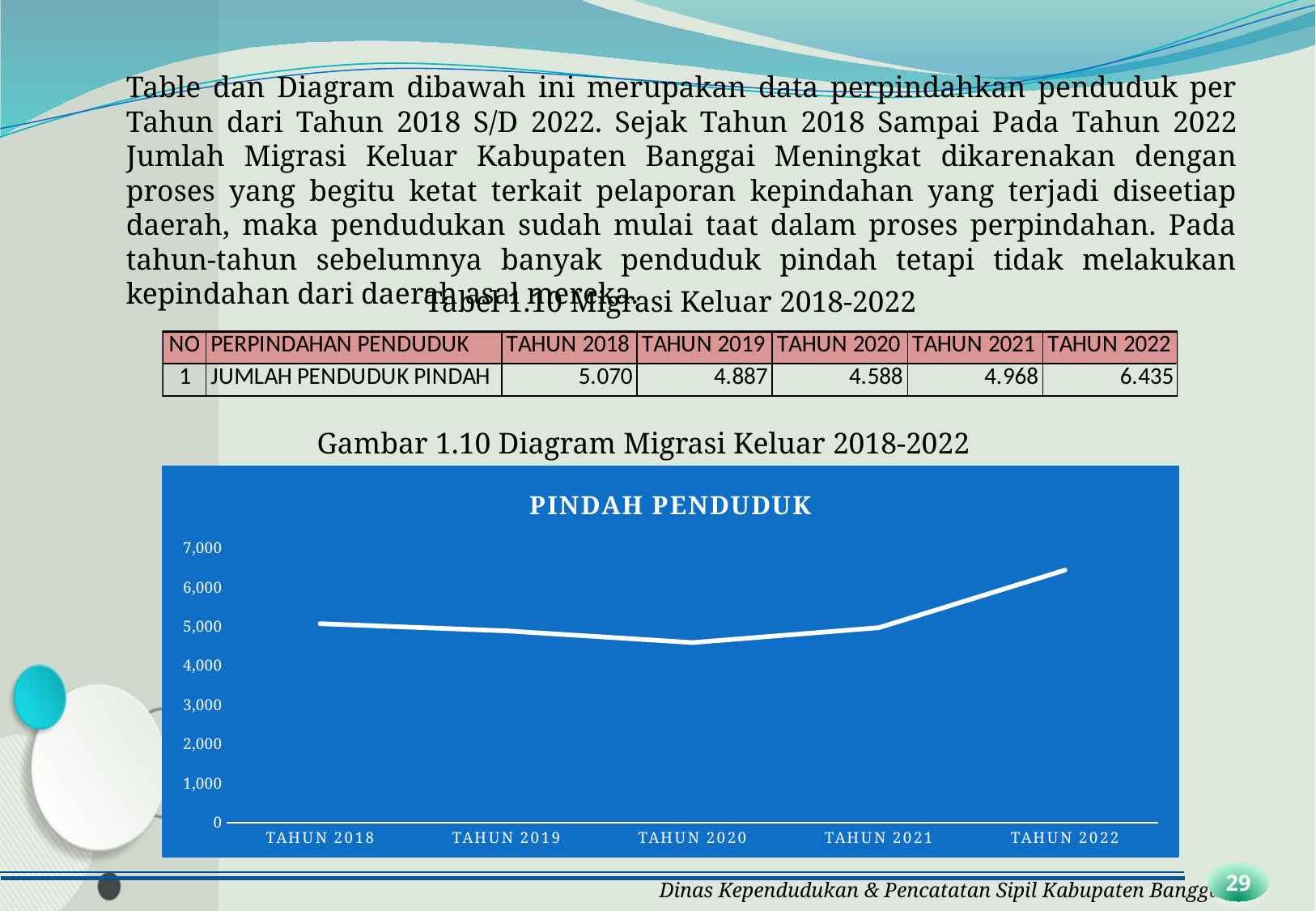
Is the value for TAHUN 2020 greater or less than 5,000? less What type of chart is shown under the title PINDAH PENDUDUK? line chart Which year has the lowest value in the chart? TAHUN 2020 Is the value for TAHUN 2020 greater or less than 4,000? greater How many years are plotted along the x axis of the chart? 5 Does the line rise or fall from TAHUN 2018 to TAHUN 2020? fall What is the title of the chart? PINDAH PENDUDUK Which year has the highest value in the chart? TAHUN 2022 Which is larger, the value for TAHUN 2022 or the value for TAHUN 2018? TAHUN 2022 According to the table, what is the JUMLAH PENDUDUK PINDAH for TAHUN 2022? 6.435 According to the table, what is the difference between the values for TAHUN 2022 and TAHUN 2021? 1.467 Is the value for TAHUN 2022 greater or less than 6,000? greater